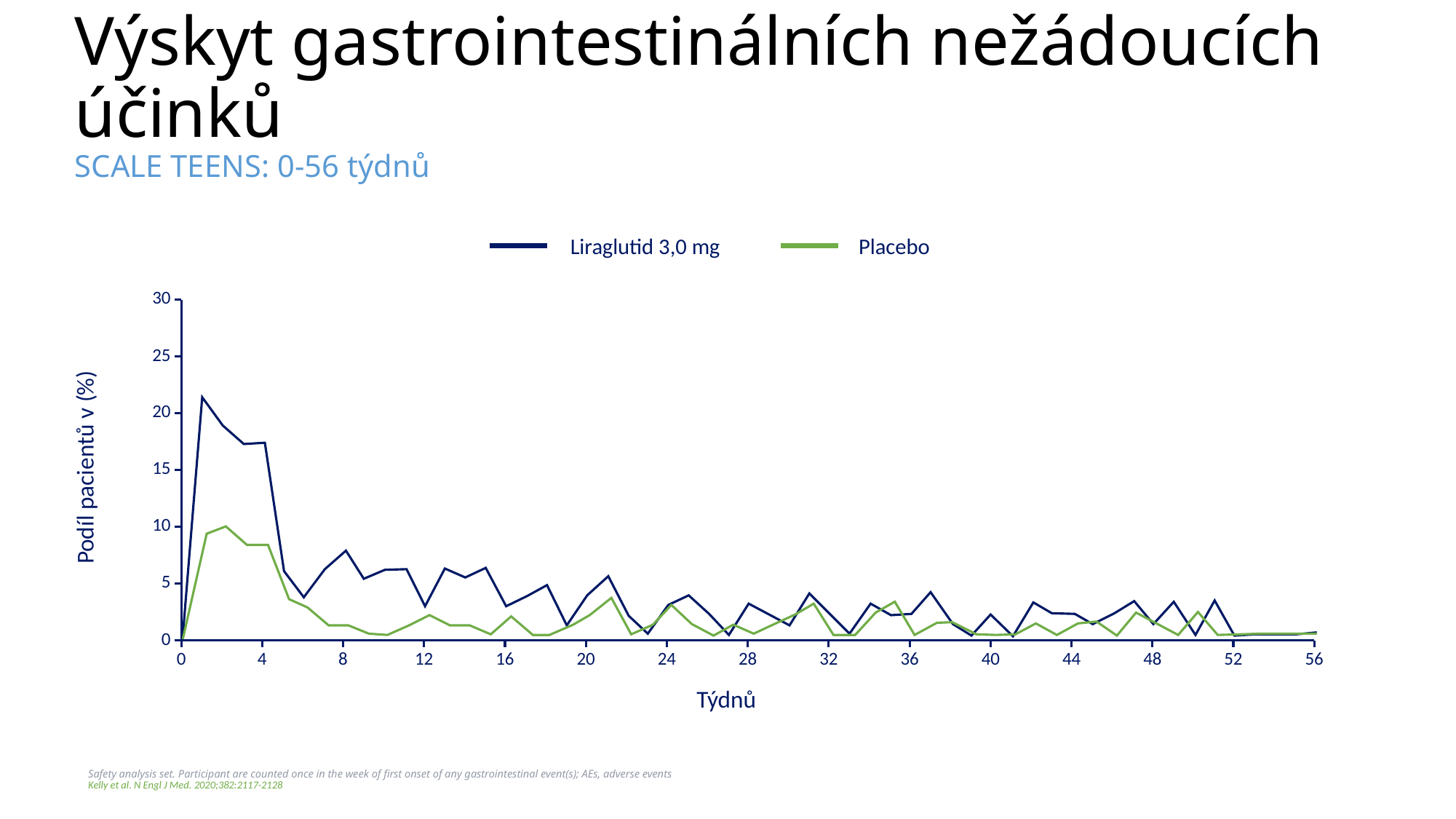
What is the highest value shown on the y axis? 30 Is the value of the Placebo line at week 8 greater or less than 5? less What is the label of the y axis? Podíl pacientů v (%) Is the value of the Liraglutid 3,0 mg line at week 4 greater or less than 15? greater What are the two series named in the legend? Liraglutid 3,0 mg and Placebo Is the value of the Placebo line at week 2 greater or less than 5? greater Which series reaches the highest value on the chart? Liraglutid 3,0 mg How many series does the legend list? 2 What kind of chart is shown on the slide? line chart Does the Liraglutid 3,0 mg line generally rise or fall between week 1 and week 8? fall At week 1, which series has the higher value, Liraglutid 3,0 mg or Placebo? Liraglutid 3,0 mg